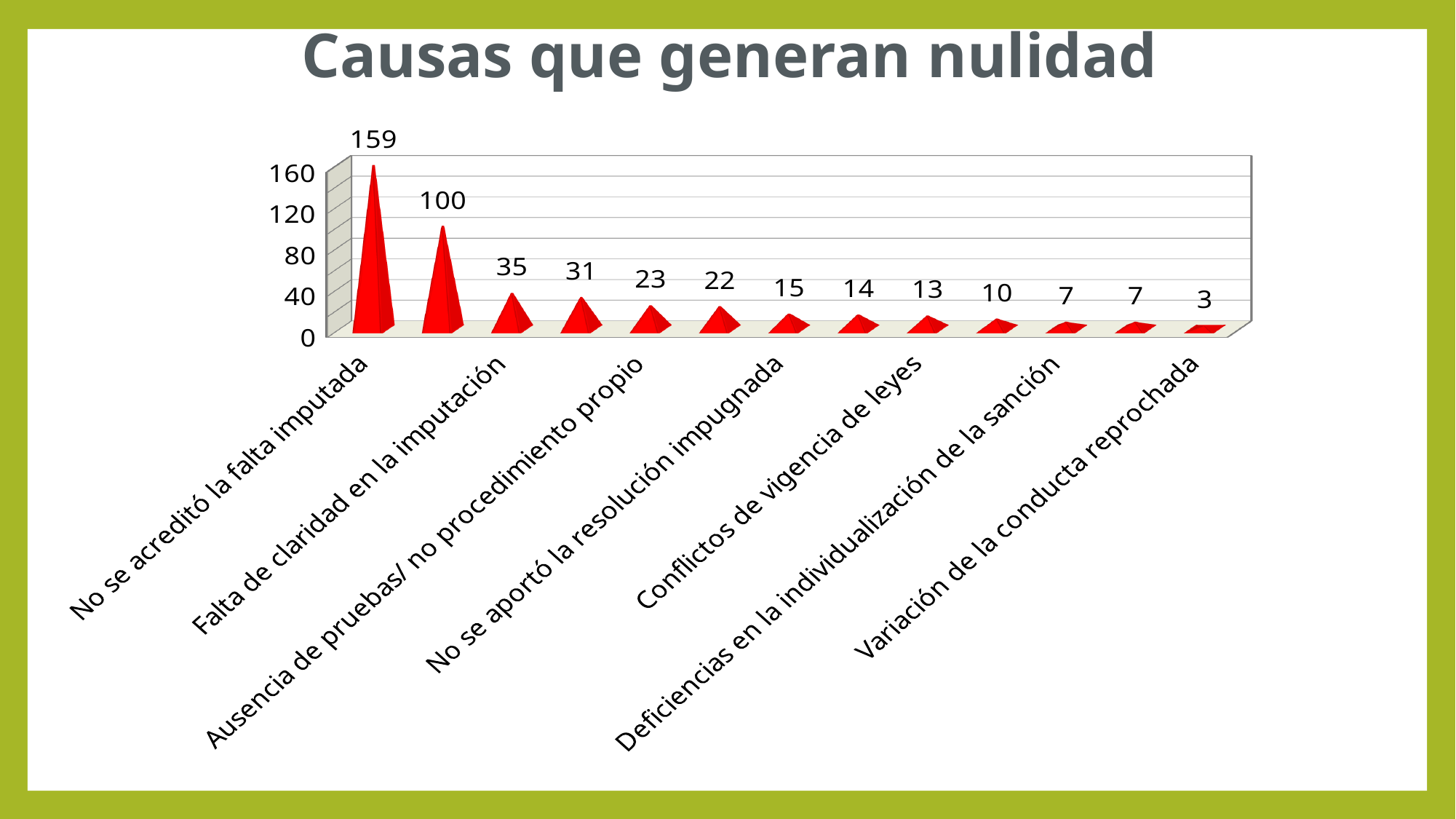
What is the highest value shown in the chart? 159 Which category has the lowest value? Variación de la conducta reprochada Do the values rise or fall from left to right along the x axis? fall What is the difference between the value for 'No se acreditó la falta imputada' and the value for 'Variación de la conducta reprochada'? 156 What type of chart is shown on the slide? bar chart What is the value for 'No se acreditó la falta imputada'? 159 What is the title of the chart? Causas que generan nulidad Which category has the highest value? No se acreditó la falta imputada How many bars are plotted in the chart? 13 Is the value for 'No se acreditó la falta imputada' greater or less than 120? greater What is the value for 'Variación de la conducta reprochada'? 3 What is the difference between the two highest values in the chart (159 and 100)? 59